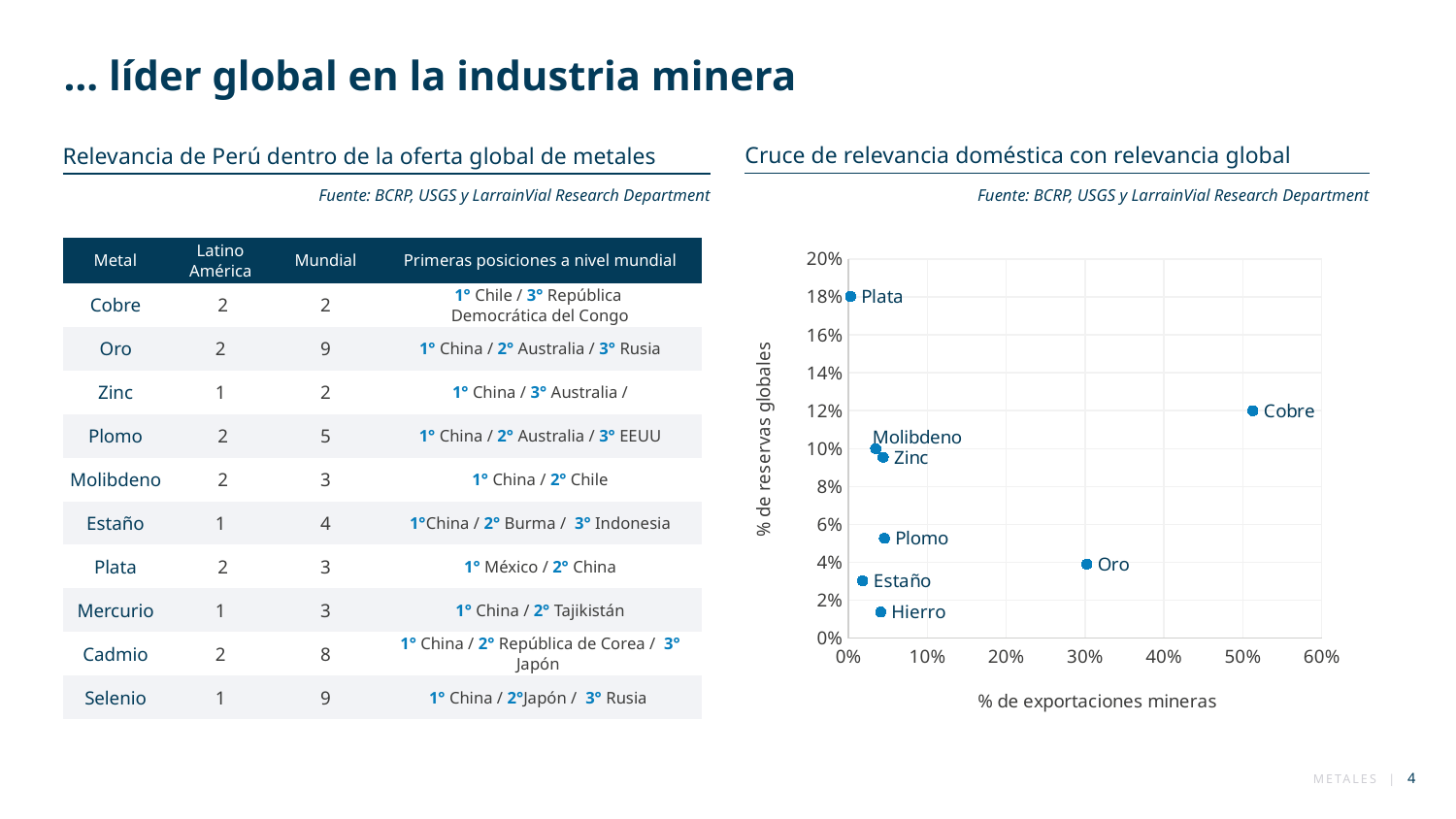
In the scatter chart, which metal has the highest % de exportaciones mineras? Cobre What kind of chart is shown under the title 'Cruce de relevancia doméstica con relevancia global'? Scatter chart In the scatter chart, which has a larger % de reservas globales, Plomo or Hierro? Plomo In the scatter chart, is the % de exportaciones mineras for Cobre greater or less than 40%? greater In the scatter chart, which metal has the lowest % de reservas globales? Hierro In the scatter chart, is the % de exportaciones mineras for Oro greater or less than 20%? greater How many metals are plotted as points in the scatter chart? 8 In the scatter chart, is the % de reservas globales for Plata greater or less than 16%? greater In the scatter chart, which has a larger % de exportaciones mineras, Cobre or Oro? Cobre In the scatter chart, which metal has the highest % de reservas globales? Plata What is the label of the horizontal axis of the scatter chart? % de exportaciones mineras